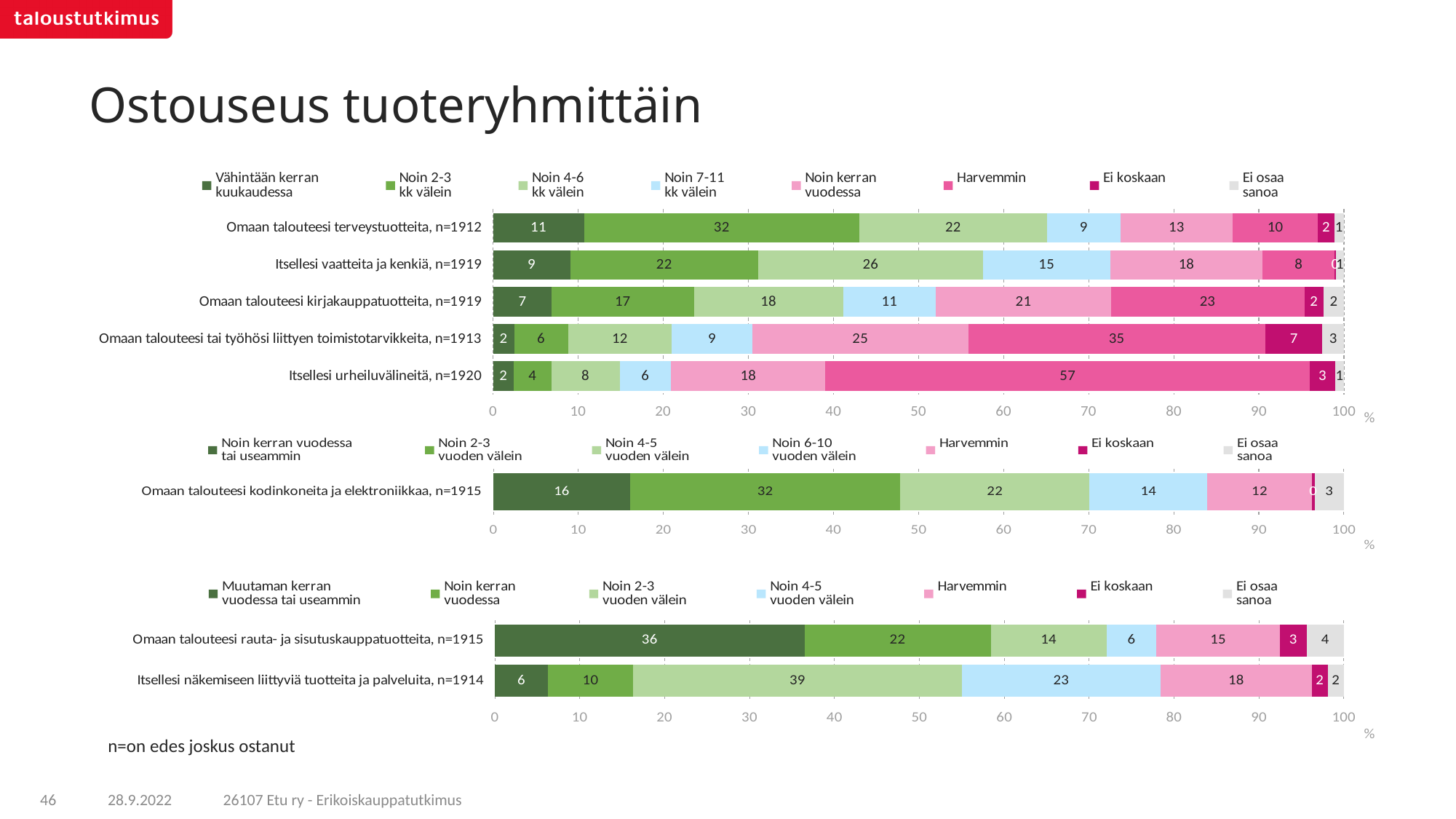
In the top chart, what is the value of 'Harvemmin' for 'Omaan talouteesi tai työhösi liittyen toimistotarvikkeita, n=1913'? 35 In the top chart, which category has the highest value for 'Vähintään kerran kuukaudessa'? Omaan talouteesi terveystuotteita, n=1912 In the bottom chart, what is the value of 'Muutaman kerran vuodessa tai useammin' for 'Omaan talouteesi rauta- ja sisutuskauppatuotteita, n=1915'? 36 How many categories (bars) does the bottom chart show? 2 In the middle chart, what is the value of 'Ei osaa sanoa'? 3 In the middle chart, what is the value of 'Noin 2-3 vuoden välein' for 'Omaan talouteesi kodinkoneita ja elektroniikkaa, n=1915'? 32 What kind of chart is the top chart? Stacked bar chart In the bottom chart, which category has the larger value for 'Noin 2-3 vuoden välein'? Itsellesi näkemiseen liittyviä tuotteita ja palveluita, n=1914 How many categories (bars) does the top chart show? 5 How many series does the legend of the top chart list? 8 In the top chart, what is the value of 'Harvemmin' for 'Itsellesi urheiluvälineitä, n=1920'? 57 In the top chart, what is the difference between the 'Noin 2-3 kk välein' values for 'Omaan talouteesi terveystuotteita, n=1912' and 'Itsellesi vaatteita ja kenkiä, n=1919'? 10